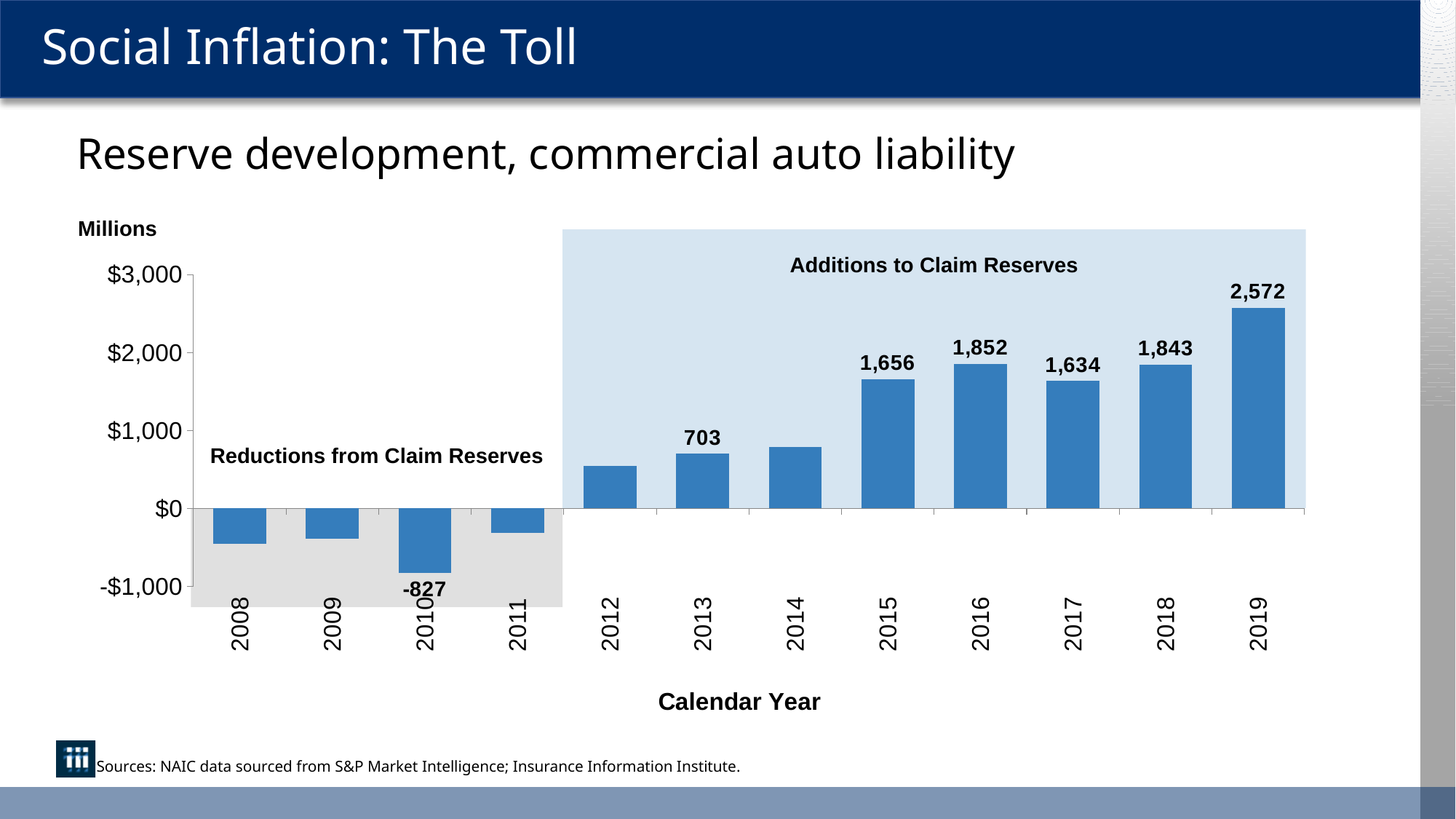
What is the value for 2016? 1,852 What is the value for 2019? 2,572 What is the value for 2013? 703 Is the value for 2014 greater or less than $1,000? less What is the difference between the values for 2019 and 2018? 729 What is the value for 2010? -827 What is the label of the x axis? Calendar Year Which is larger, the value for 2015 or the value for 2017? 2015 How many calendar years are shown on the x axis? 12 What kind of chart is shown on the slide? bar chart Which year has the lowest value? 2010 Which year has the highest value? 2019